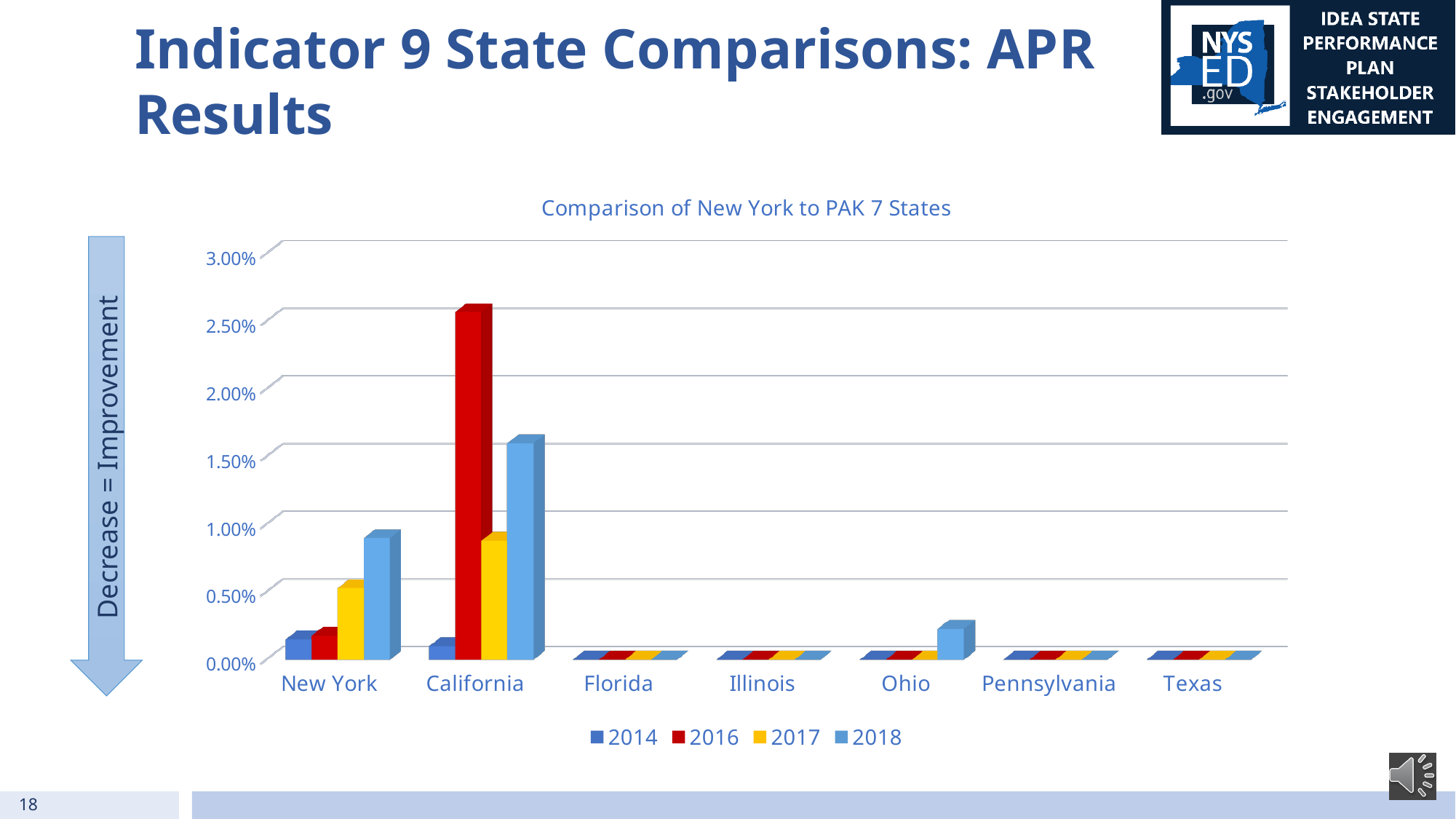
How many series does the chart's legend list? 4 Is the 2018 value for Ohio greater or less than 0.50%? less What kind of chart is shown on the slide? Bar chart Is the 2016 value for California greater or less than 2.00%? greater Do New York's values rise or fall from 2014 to 2018? rise Which state has the highest 2018 value in the chart? California Is the 2018 value for New York greater or less than 1.00%? less Which state has the highest 2016 value in the chart? California What is the title of the chart? Comparison of New York to PAK 7 States Which is larger, the 2016 value for California or the 2016 value for New York? California How many states are shown on the x axis of the chart? 7 Which years are listed in the chart's legend? 2014, 2016, 2017, 2018